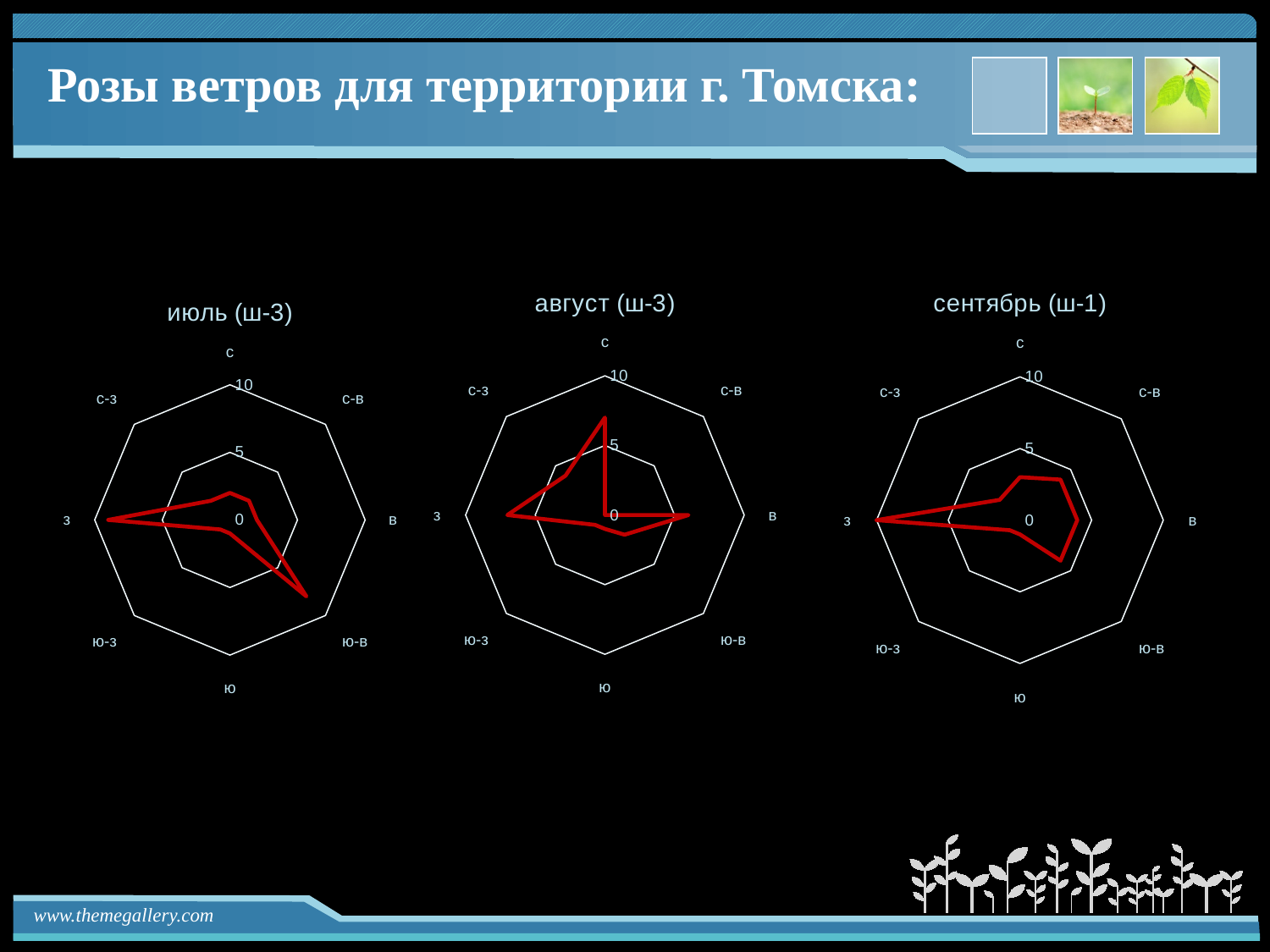
What kind of chart is the "июль (ш-3)" chart? radar chart In the "июль (ш-3)" chart, is the value for с greater or less than 5? less How many direction categories does the "август (ш-3)" chart have? 8 In the "август (ш-3)" chart, is the value for ю-в greater or less than 5? less In the "июль (ш-3)" chart, is the value for ю-в greater or less than 5? greater How many charts are shown on the slide? 3 In the "сентябрь (ш-1)" chart, which direction has the highest value? з What is the title of the rightmost chart? сентябрь (ш-1)